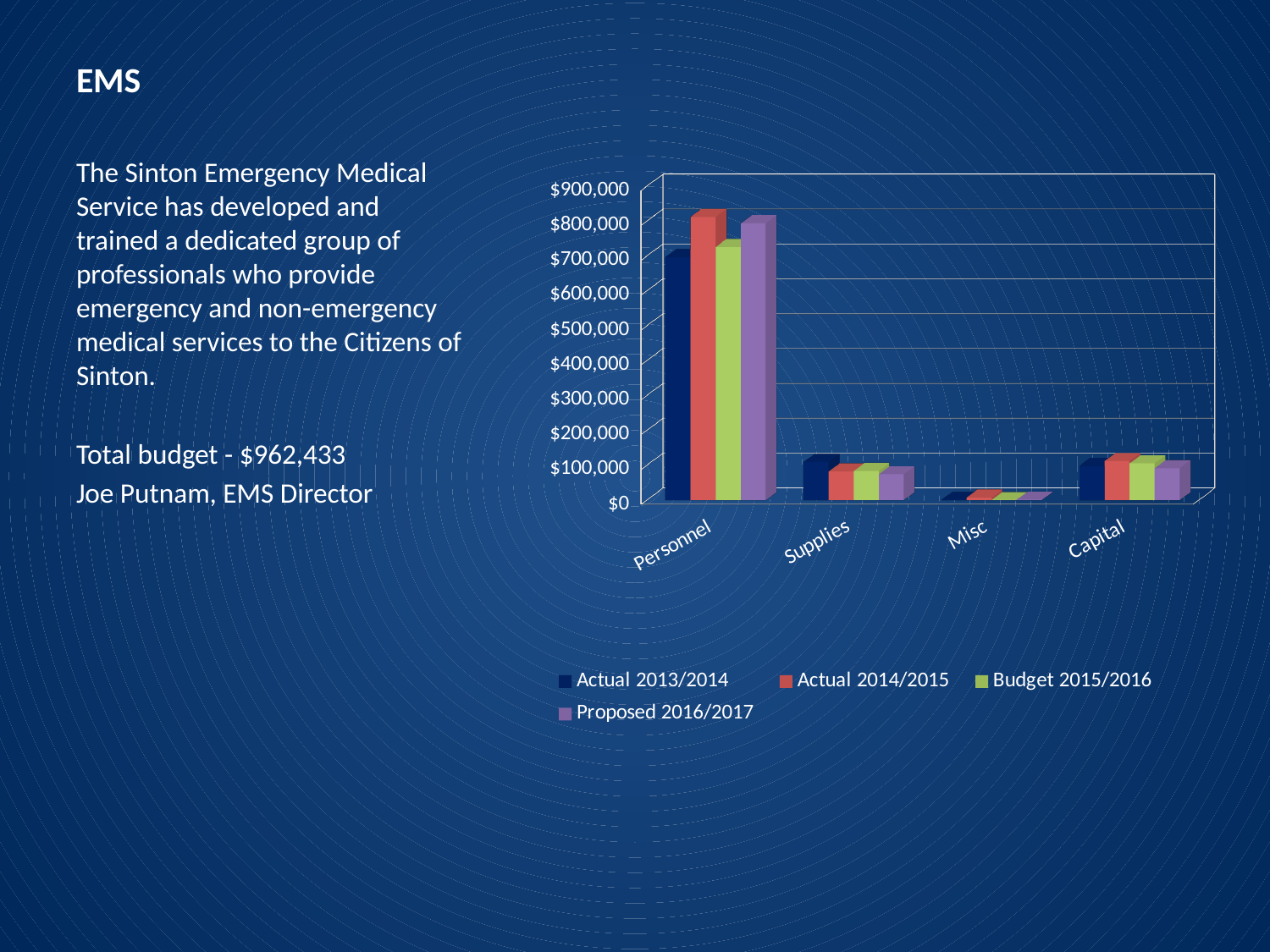
What kind of chart is shown on the slide? Bar chart Is the Misc value for Proposed 2016/2017 greater or less than $100,000? less Which series is listed last in the chart's legend? Proposed 2016/2017 Which category has the highest values in the chart? Personnel For Actual 2013/2014, which is larger: Personnel or Supplies? Personnel For Proposed 2016/2017, which is larger: Misc or Capital? Capital Is the Supplies value for Actual 2013/2014 greater or less than $200,000? less Is the Personnel value for Actual 2014/2015 greater or less than $500,000? greater How many categories are shown on the x axis of the chart? 4 Which category has the lowest values in the chart? Misc How many series does the chart's legend list? 4